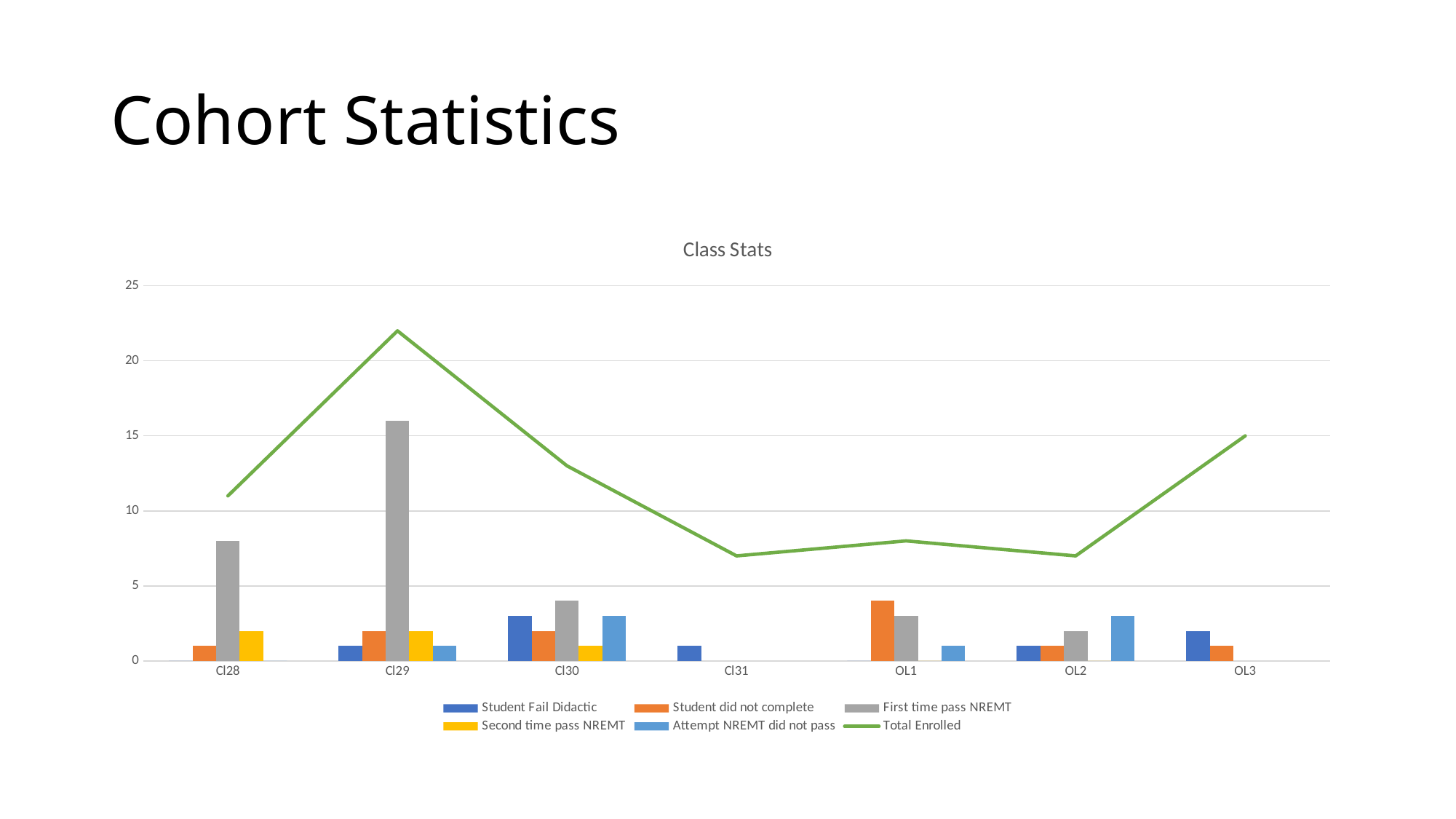
How many categories are shown on the x axis? 7 What kind of chart is shown on the slide? Combined bar and line chart Which category has the highest Total Enrolled? Cl29 Is the First time pass NREMT value for Cl28 greater or less than 10? less Does the Total Enrolled line rise or fall from Cl29 to Cl31? fall How many series does the legend list? 6 Which category has the highest First time pass NREMT value? Cl29 Is the Total Enrolled value for Cl29 greater or less than 20? greater Which series is plotted as a line rather than bars? Total Enrolled Which has the larger Student did not complete value, Cl28 or OL1? OL1 What is the title of the chart? Class Stats Is the Total Enrolled value for Cl31 greater or less than 10? less